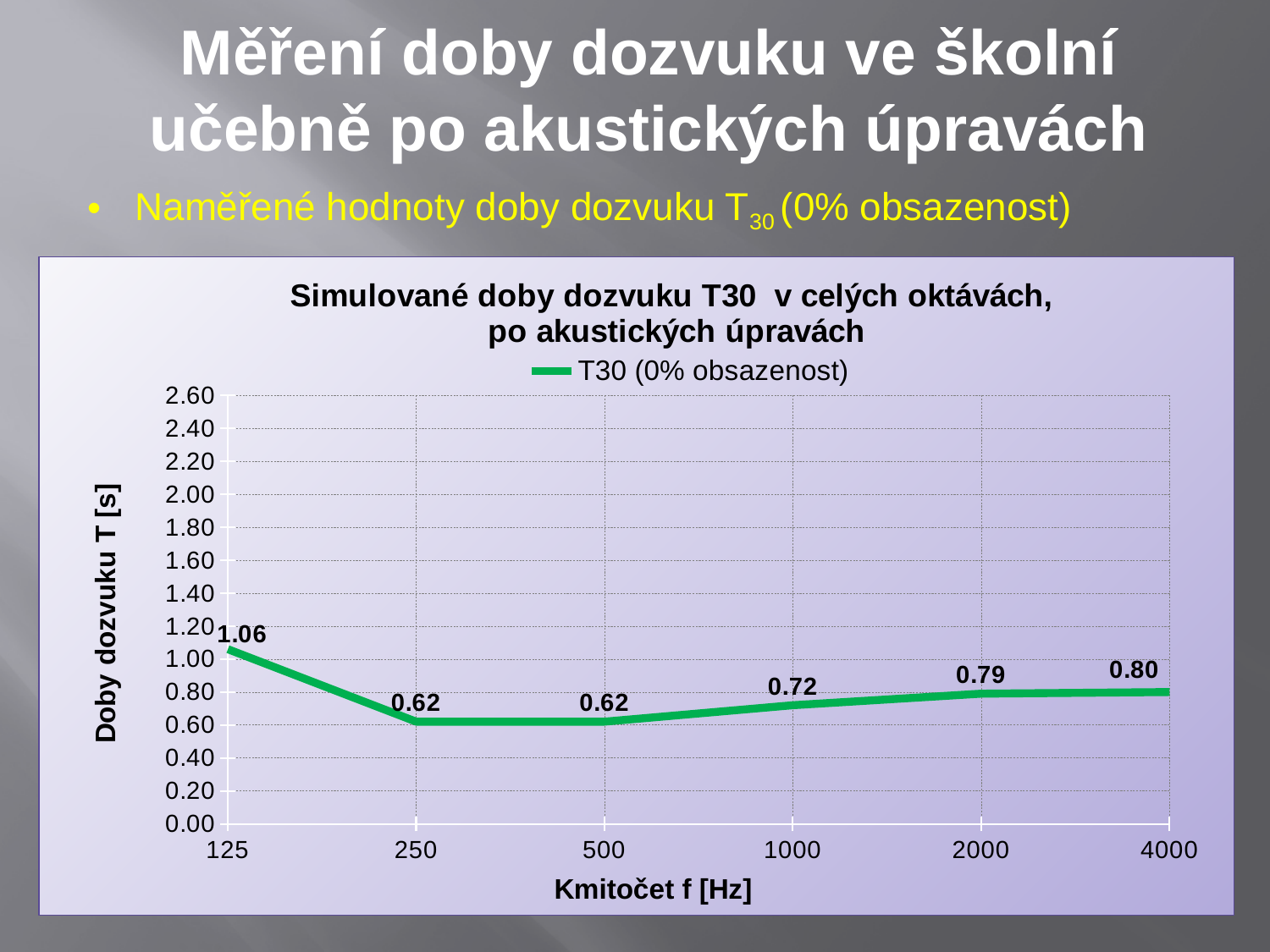
How many frequency points are plotted on the chart? 6 What is the T30 value at 1000 Hz? 0.72 What is the label of the y axis? Doby dozvuku T [s] At which frequency is the reverberation time T30 highest? 125 What is the T30 value at 125 Hz? 1.06 What kind of chart is shown on the slide? line chart What is the lowest T30 value plotted on the chart? 0.62 Which is larger, the T30 value at 2000 Hz or at 1000 Hz? 2000 Hz Is the T30 value at 500 Hz greater or less than 1.00? less What is the difference between the T30 value at 125 Hz and at 250 Hz? 0.44 How many series does the legend list? 1 What is the T30 value at 4000 Hz? 0.80